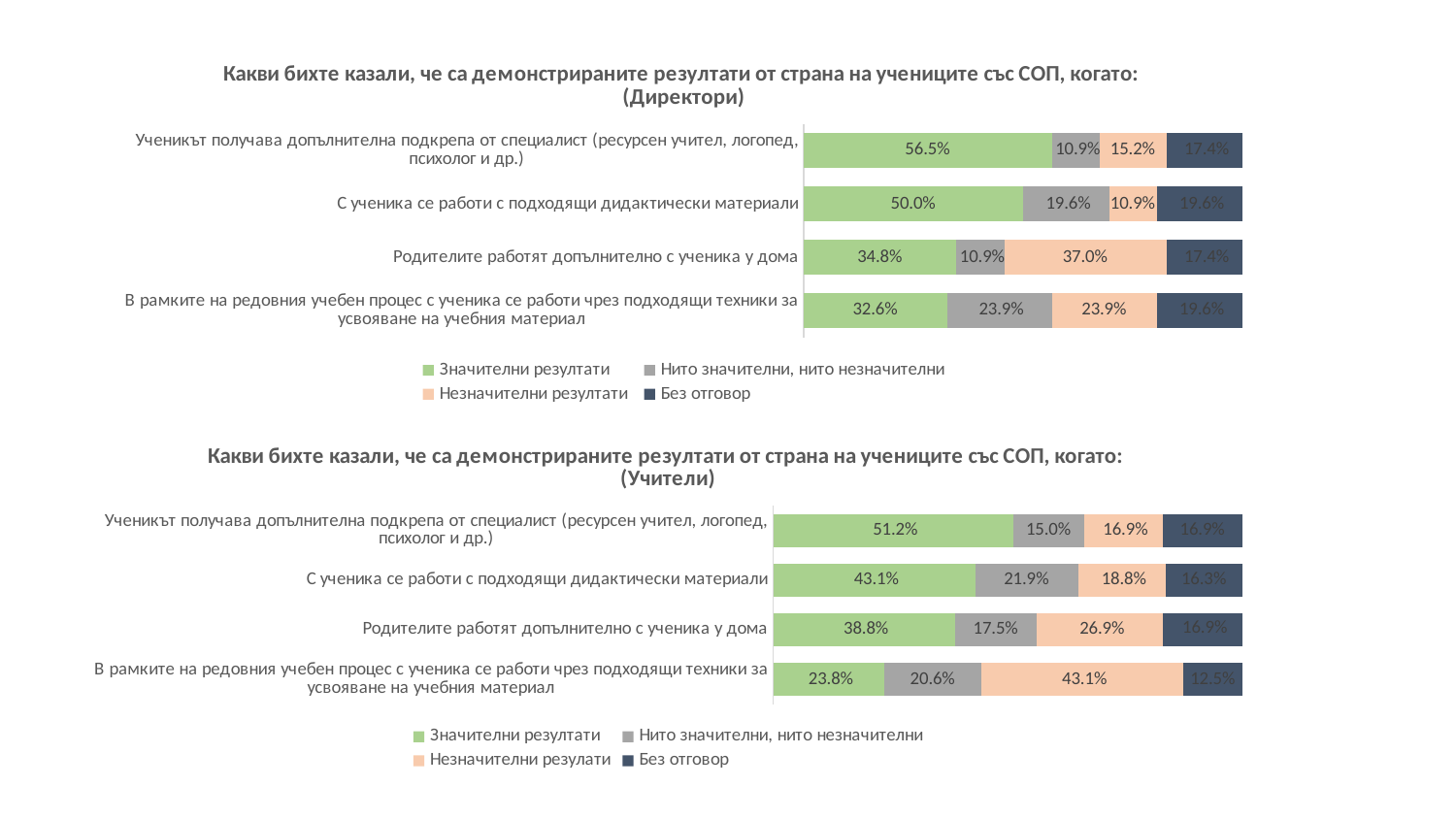
In the top chart (Директори), which category has the highest value for 'Значителни резултати'? Ученикът получава допълнителна подкрепа от специалист (ресурсен учител, логопед, психолог и др.) In the top chart (Директори), what is the difference between 'Значителни резултати' and 'Незначителни резултати' for 'С ученика се работи с подходящи дидактически материали'? 39.1% In the bottom chart (Учители), which is larger for 'Родителите работят допълнително с ученика у дома': 'Значителни резултати' or 'Незначителни резултати'? Значителни резултати In the bottom chart (Учители), what is the value of 'Незначителни резултати' for 'В рамките на редовния учебен процес с ученика се работи чрез подходящи техники за усвояване на учебния материал'? 43.1% In the bottom chart (Учители), which category has the lowest value for 'Значителни резултати'? В рамките на редовния учебен процес с ученика се работи чрез подходящи техники за усвояване на учебния материал In the bottom chart (Учители), what is the value of 'Без отговор' for 'С ученика се работи с подходящи дидактически материали'? 16.3% In the bottom chart (Учители), what is the difference between 'Значителни резултати' for 'Ученикът получава допълнителна подкрепа от специалист (ресурсен учител, логопед, психолог и др.)' and for 'С ученика се работи с подходящи дидактически материали'? 8.1% How many categories are shown in the bottom chart (Учители)? 4 In the top chart (Директори), what is the value of 'Значителни резултати' for 'Ученикът получава допълнителна подкрепа от специалист (ресурсен учител, логопед, психолог и др.)'? 56.5% What type of chart is the top chart (Директори)? Stacked bar chart In the top chart (Директори), what is the value of 'Незначителни резултати' for 'Родителите работят допълнително с ученика у дома'? 37.0% In the top chart (Директори), how many series does the legend list? 4